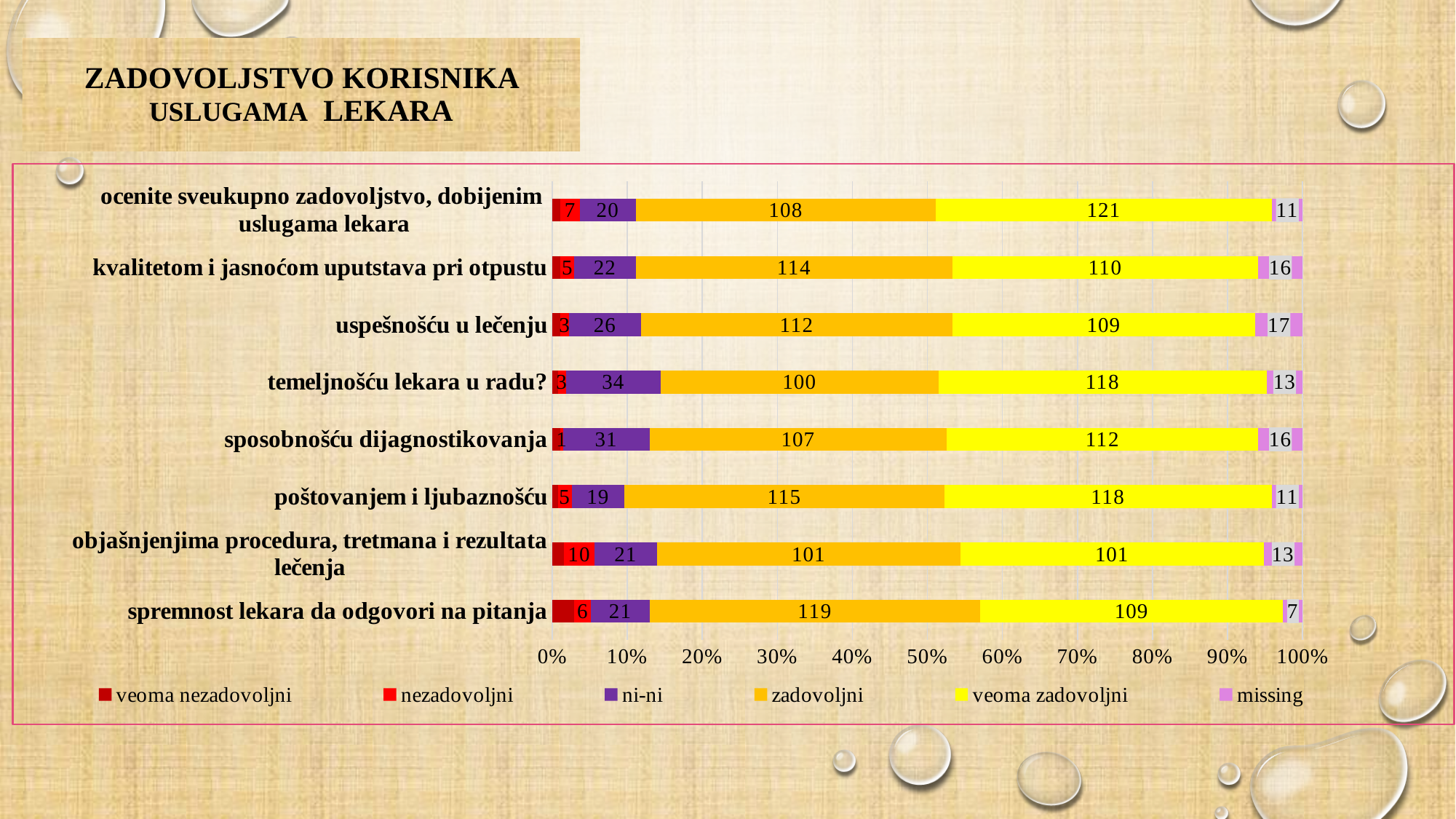
For 'kvalitetom i jasnoćom uputstava pri otpustu', which is larger: 'zadovoljni' or 'veoma zadovoljni'? zadovoljni Which category has the highest 'veoma zadovoljni' value? ocenite sveukupno zadovoljstvo, dobijenim uslugama lekara What is the value of the 'zadovoljni' segment for 'ocenite sveukupno zadovoljstvo, dobijenim uslugama lekara'? 108 How many categories are shown on the chart? 8 Which category has the lowest 'ni-ni' value? poštovanjem i ljubaznošću What is the 'veoma zadovoljni' value for 'temeljnošću lekara u radu?'? 118 How many series does the legend list? 6 Which category has the highest 'zadovoljni' value? spremnost lekara da odgovori na pitanja What is the 'ni-ni' value for 'sposobnošću dijagnostikovanja'? 31 For 'ocenite sveukupno zadovoljstvo, dobijenim uslugama lekara', what is the difference between the 'veoma zadovoljni' and 'zadovoljni' values? 13 What is the 'missing' value for 'spremnost lekara da odgovori na pitanja'? 7 What is the 'nezadovoljni' value for 'objašnjenjima procedura, tretmana i rezultata lečenja'? 10